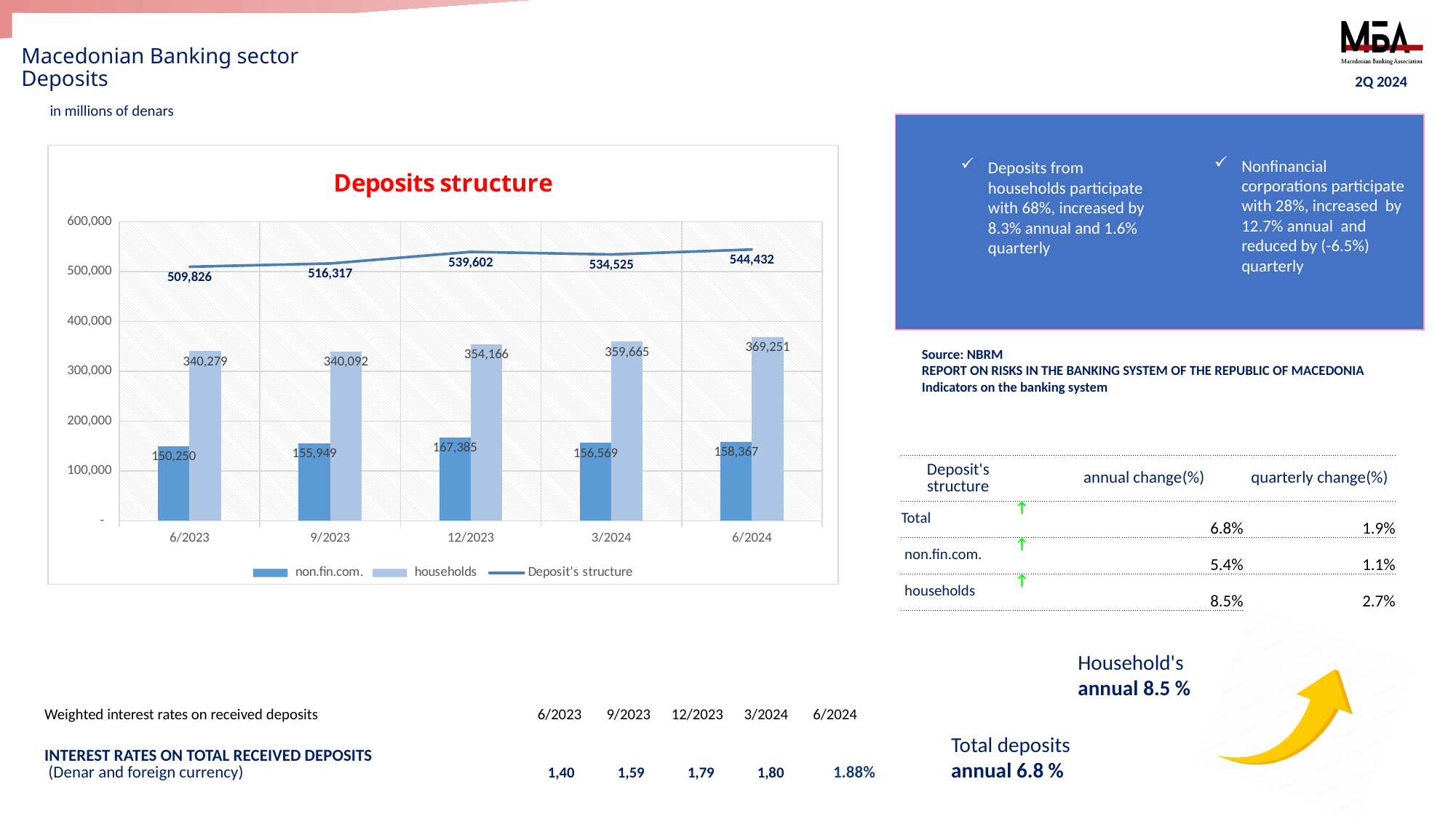
How many series does the legend of the Deposits structure chart list? 3 How many periods are shown on the x axis of the Deposits structure chart? 5 What is the value for households in 6/2024 in the Deposits structure chart? 369,251 Is the households value in 12/2023 greater or less than 300,000? greater Does the households series rise or fall from 12/2023 to 6/2024? rise What kind of chart is the Deposits structure chart? Combined bar and line chart In which period is the Deposit's structure line highest? 6/2024 In which period is the non.fin.com. value lowest? 6/2023 What is the value of the Deposit's structure line in 6/2023? 509,826 Which is larger in 3/2024: the households value or the non.fin.com. value? households What is the value for non.fin.com. in 12/2023 in the Deposits structure chart? 167,385 What is the difference between the households value and the non.fin.com. value in 6/2024? 210,884